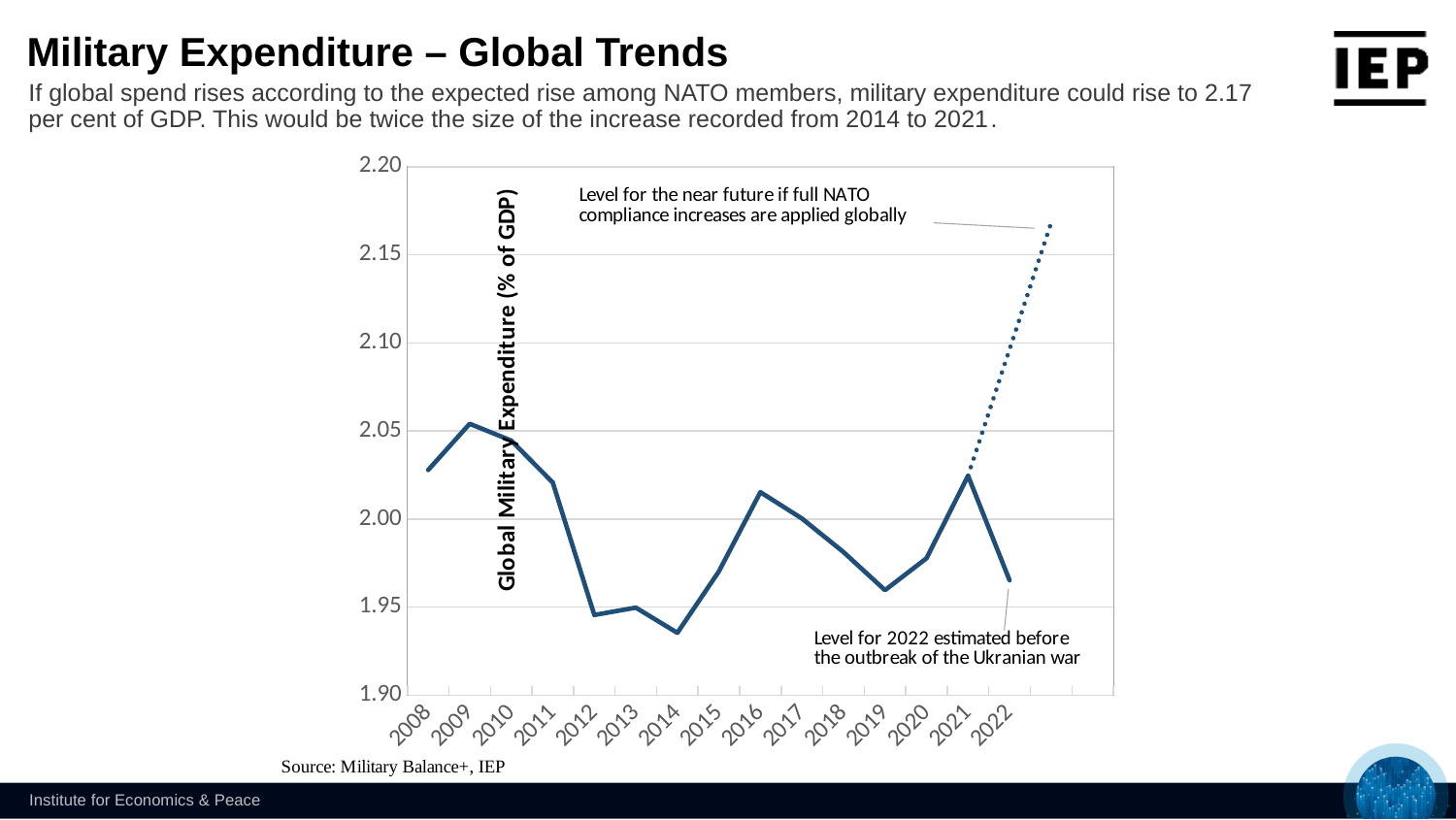
Which year has the lowest global military expenditure on the solid line? 2014 Is the value for 2022 greater or less than 2.00? less Is the value for 2021 greater or less than 2.00? greater What is the title of the vertical axis? Global Military Expenditure (% of GDP) Do the values rise or fall from 2009 to 2014? fall Which year has the larger value, 2016 or 2019? 2016 What kind of chart is shown on the slide? line chart How many years are labelled along the x axis of the chart? 15 Is the value for 2016 greater or less than 2.00? greater Which year has the highest global military expenditure on the solid line? 2009